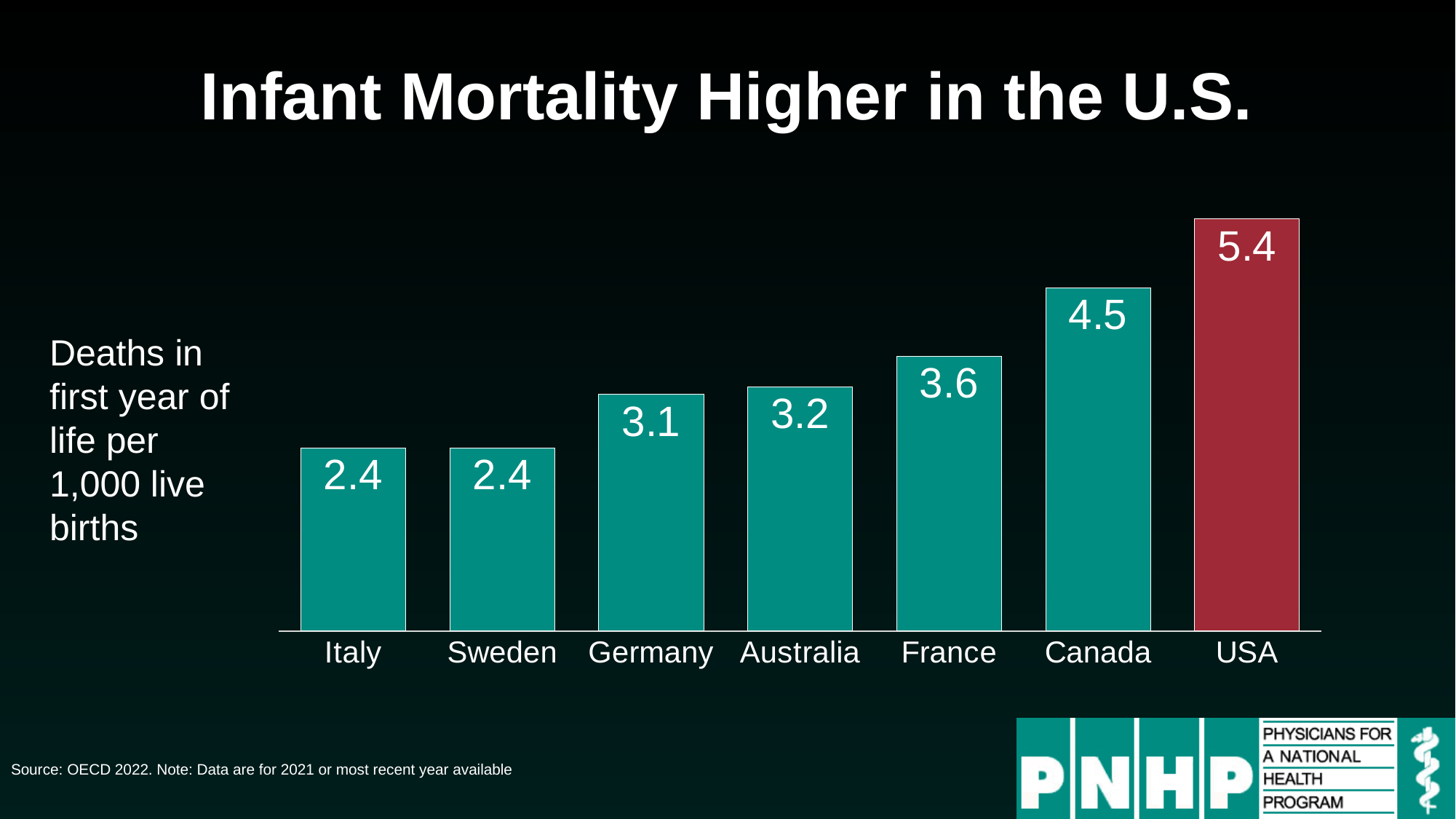
What is the difference between the USA value and the Canada value? 0.9 What is the infant mortality value shown for the USA? 5.4 Which has a higher value, France or Australia? France How many countries are shown on the chart? 7 Which country has the highest infant mortality on the chart? USA Do the values rise or fall moving from Italy to USA along the x axis? Rise Which bar is coloured differently (red) from the others? USA What is the value shown for France? 3.6 Which countries share the lowest value on the chart? Italy and Sweden What kind of chart is shown on the slide? Bar chart What is the value shown for Germany? 3.1 What is the difference between the Australia value and the Italy value? 0.8